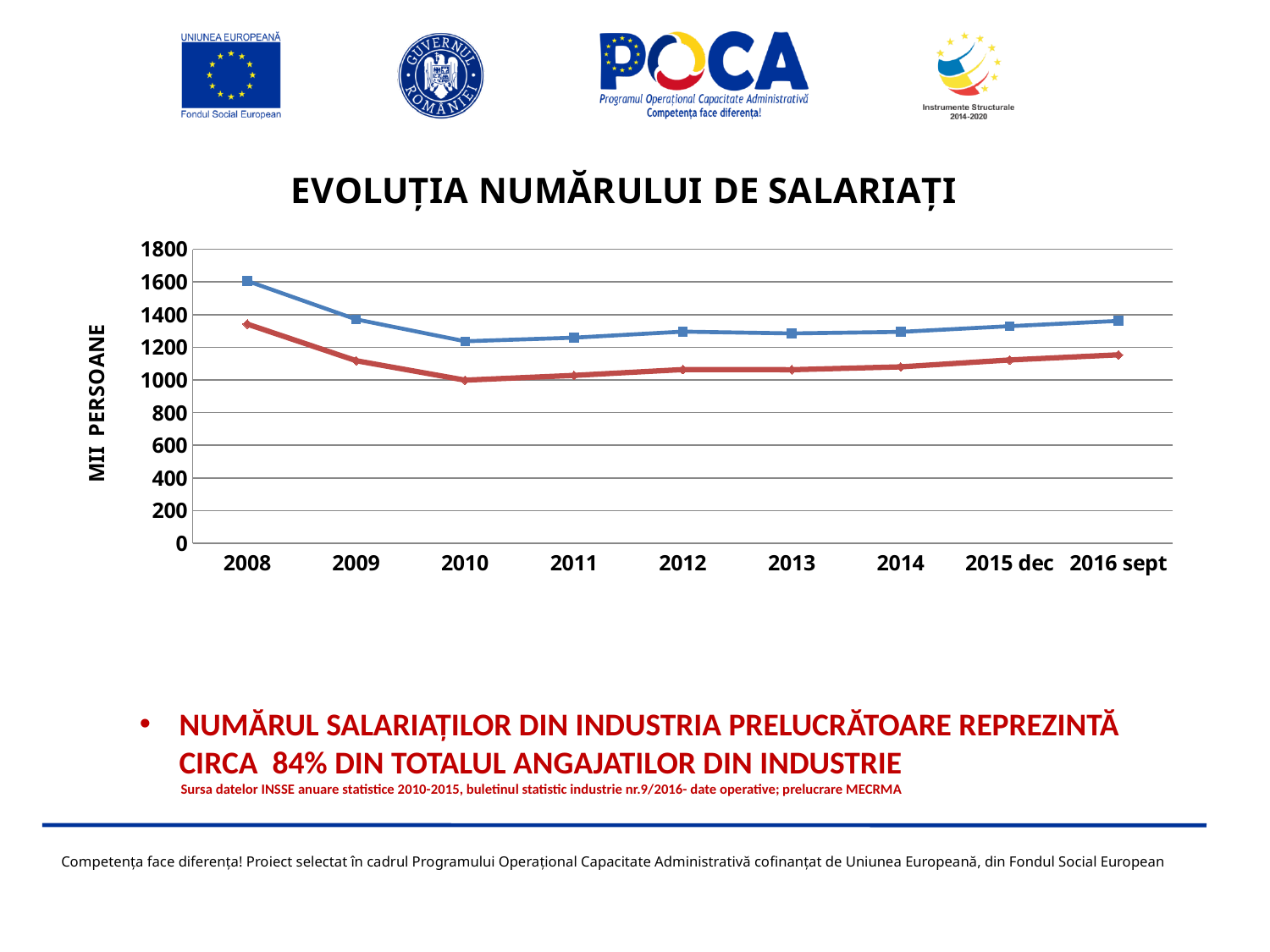
How many time points are plotted along the x axis? 9 Is the value of the red line in 2009 greater or less than 1200? less In which year does the blue line reach its highest value? 2008 In which year does the blue line reach its lowest value? 2010 What kind of chart is shown on the slide? line chart Do the values of the red line rise or fall from 2010 to 2016 sept? rise What is the title of the chart? EVOLUȚIA NUMĂRULUI DE SALARIAȚI What is the label on the vertical axis? MII PERSOANE In which year does the red line reach its lowest value? 2010 Is the value of the blue line at 2016 sept greater or less than 1400? less Is the value of the blue line in 2008 greater or less than 1400? greater Which line is higher in 2012, the blue line or the red line? blue line